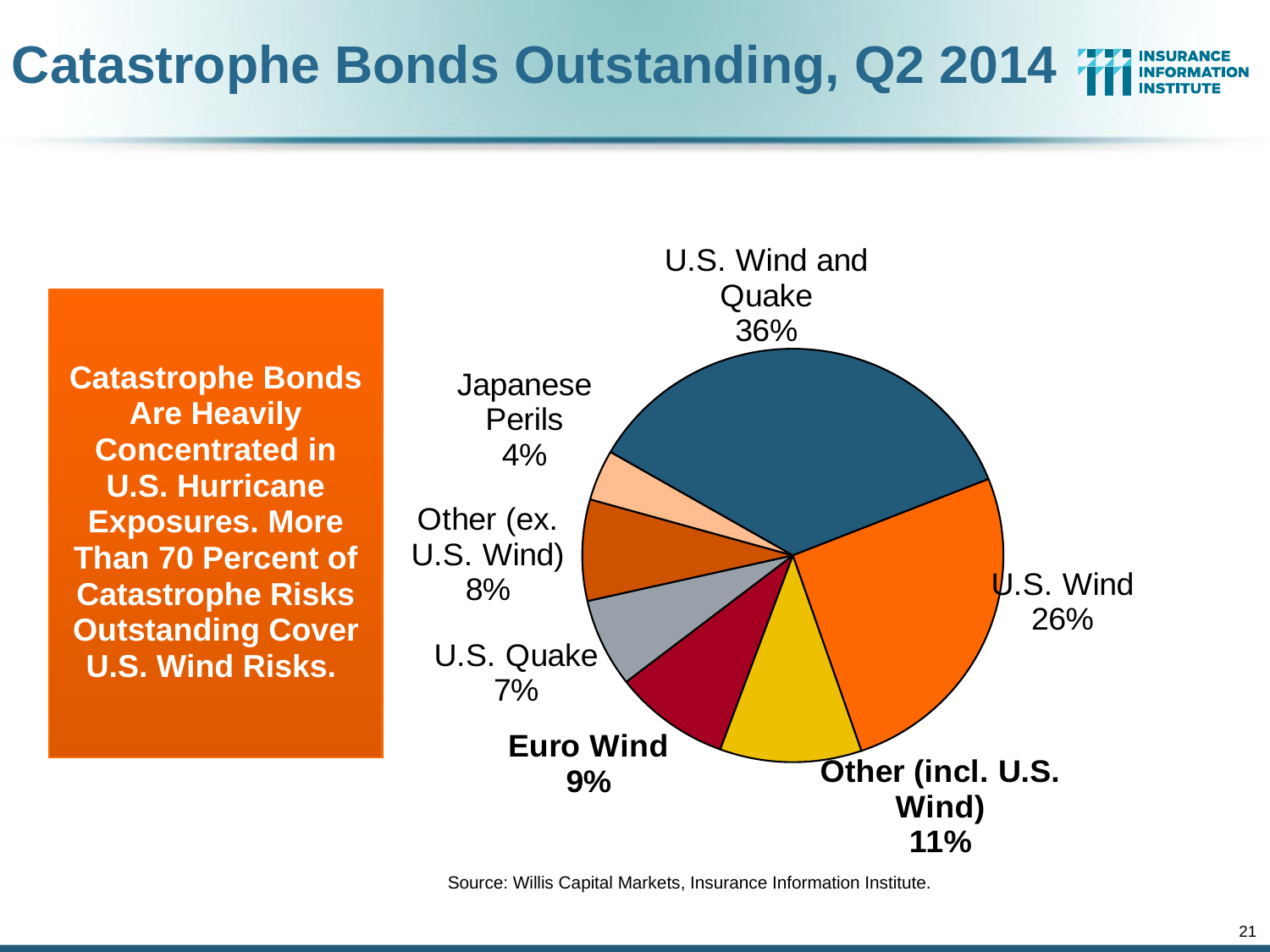
What share of catastrophe bonds outstanding is U.S. Wind and Quake? 36% Which category has the smallest share of catastrophe bonds outstanding? Japanese Perils What is the source cited for the chart? Willis Capital Markets, Insurance Information Institute What is the difference in percentage points between U.S. Wind and Quake and U.S. Wind? 10 percentage points What share of catastrophe bonds outstanding is Euro Wind? 9% Which category has the largest share of catastrophe bonds outstanding? U.S. Wind and Quake How many categories are shown in the pie chart? 7 What kind of chart is shown on the slide? Pie chart Which is larger, the share for U.S. Quake or the share for Other (ex. U.S. Wind)? Other (ex. U.S. Wind) What share of catastrophe bonds outstanding is U.S. Wind? 26% What share of catastrophe bonds outstanding is Japanese Perils? 4% What share of catastrophe bonds outstanding is Other (incl. U.S. Wind)? 11%